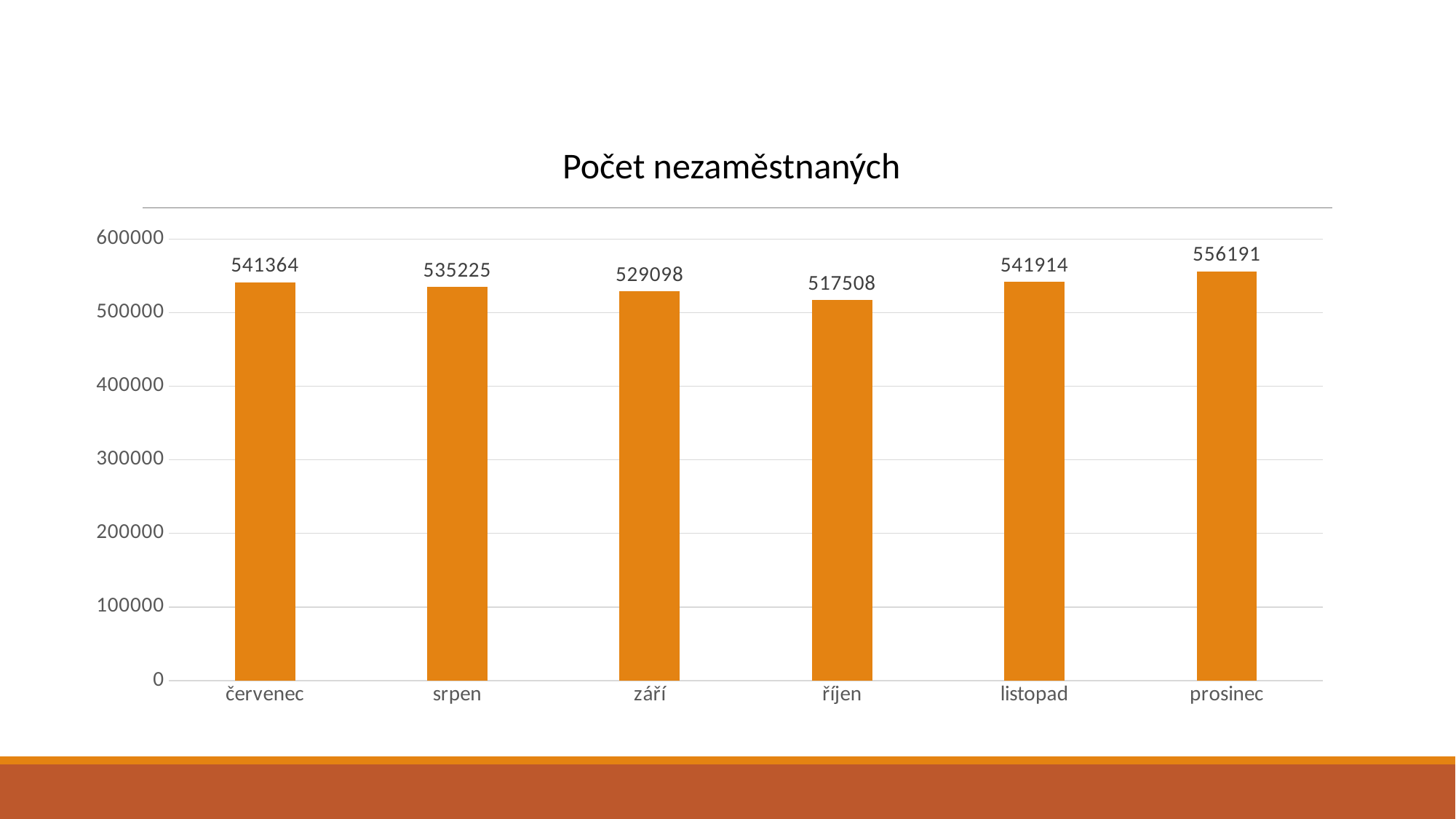
Is the value for září greater or less than 500000? greater What is the value for prosinec? 556191 What kind of chart is this? bar chart What is the difference between the values for prosinec and říjen? 38683 What is the value for říjen? 517508 What is the difference between the values for srpen and září? 6127 Which is larger, the value for listopad or the value for červenec? listopad Which month has the lowest value? říjen What is the value for červenec? 541364 Which month has the highest value? prosinec What is the title of the chart? Počet nezaměstnaných How many months are shown on the x axis? 6